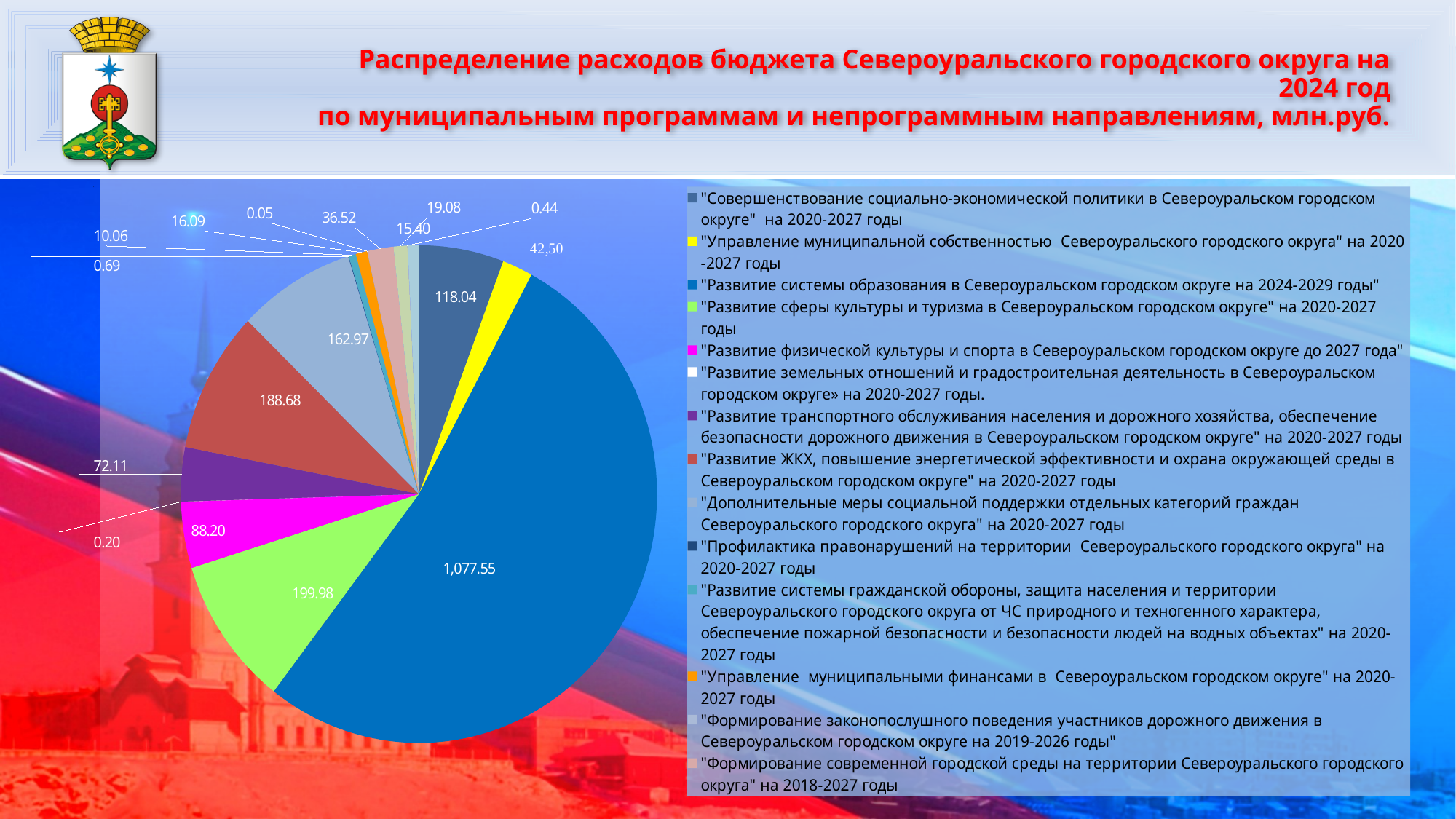
What kind of chart is shown on the slide? pie chart What is the largest value shown on the pie chart? 1,077.55 What is the value of the purple slice for "Развитие транспортного обслуживания населения и дорожного хозяйства"? 72.11 What is the smallest value labelled on the pie chart? 0.05 What is the value of the blue slice for "Развитие системы образования в Североуральском городском округе на 2024-2029 годы"? 1,077.55 What is the difference between the slice labelled 1,077.55 and the slice labelled 199.98? 877.57 What is the difference between the slices labelled 188.68 and 162.97? 25.71 What is the value of the green slice for "Развитие сферы культуры и туризма в Североуральском городском округе"? 199.98 What is the value of the yellow slice for "Управление муниципальной собственностью Североуральского городского округа"? 42,50 Which is larger: the slice labelled 118.04 or the slice labelled 88.20? 118.04 What is the value of the magenta slice for "Развитие физической культуры и спорта в Североуральском городском округе до 2027 года"? 88.20 In what units are the values on the chart expressed, according to the slide title? млн.руб.